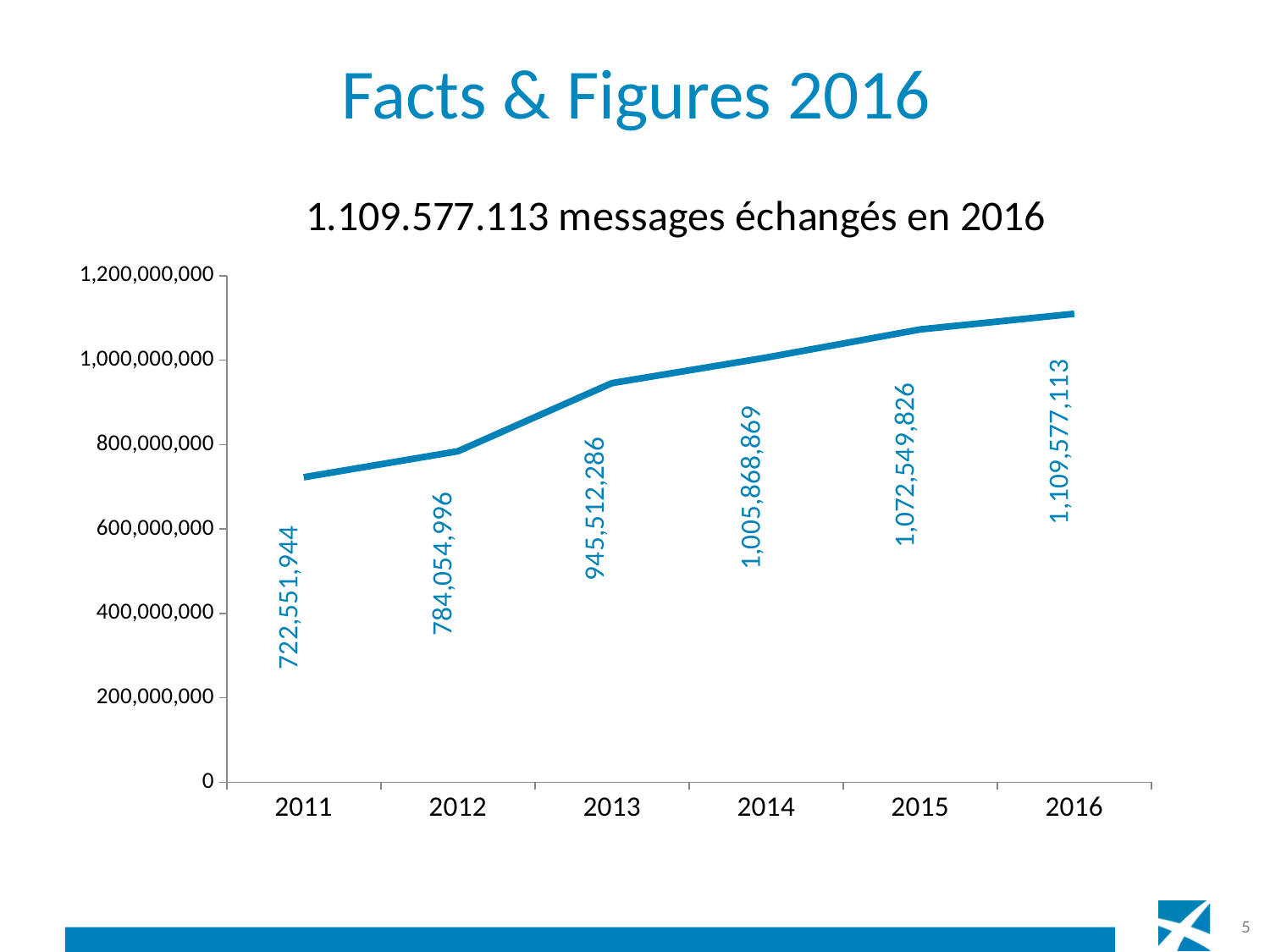
What is the value plotted for 2013? 945,512,286 What is the value plotted for 2016? 1,109,577,113 Which year has the highest value on the chart? 2016 What is the value plotted for 2011? 722,551,944 Which year has the larger value, 2014 or 2012? 2014 What is the difference between the values for 2016 and 2015? 37,027,287 What is the difference between the values for 2013 and 2012? 161,457,290 Which year has the lowest value on the chart? 2011 What kind of chart is shown on the slide? line chart How many years are plotted on the chart? 6 Is the value for 2013 greater or less than 1,000,000,000? less Do the values rise or fall from 2011 to 2016? rise